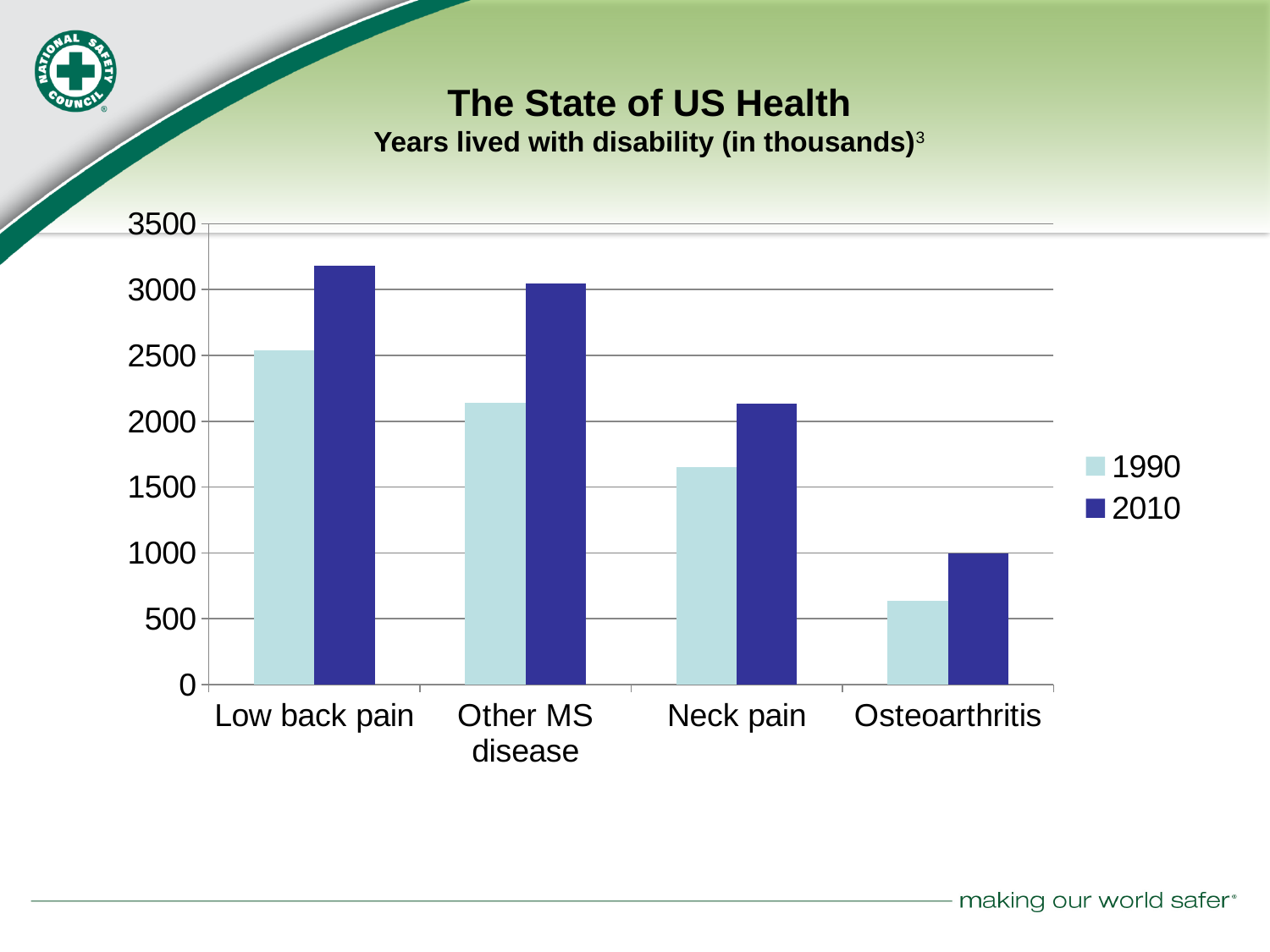
Which legend entry is shown in dark blue? 2010 Which is larger for Neck pain, the 1990 value or the 2010 value? 2010 How many series does the legend list? 2 What kind of chart is shown on the slide? bar chart Do the 1990 values rise or fall moving from Low back pain to Osteoarthritis along the x axis? fall Is the value for Osteoarthritis in 1990 greater or less than 500? greater Which category has the lowest value for 1990? Osteoarthritis Which category has the highest value for 2010? Low back pain Is the value for Neck pain in 1990 greater or less than 2000? less How many categories are shown on the x axis? 4 Is the value for Other MS disease in 1990 greater or less than 2500? less